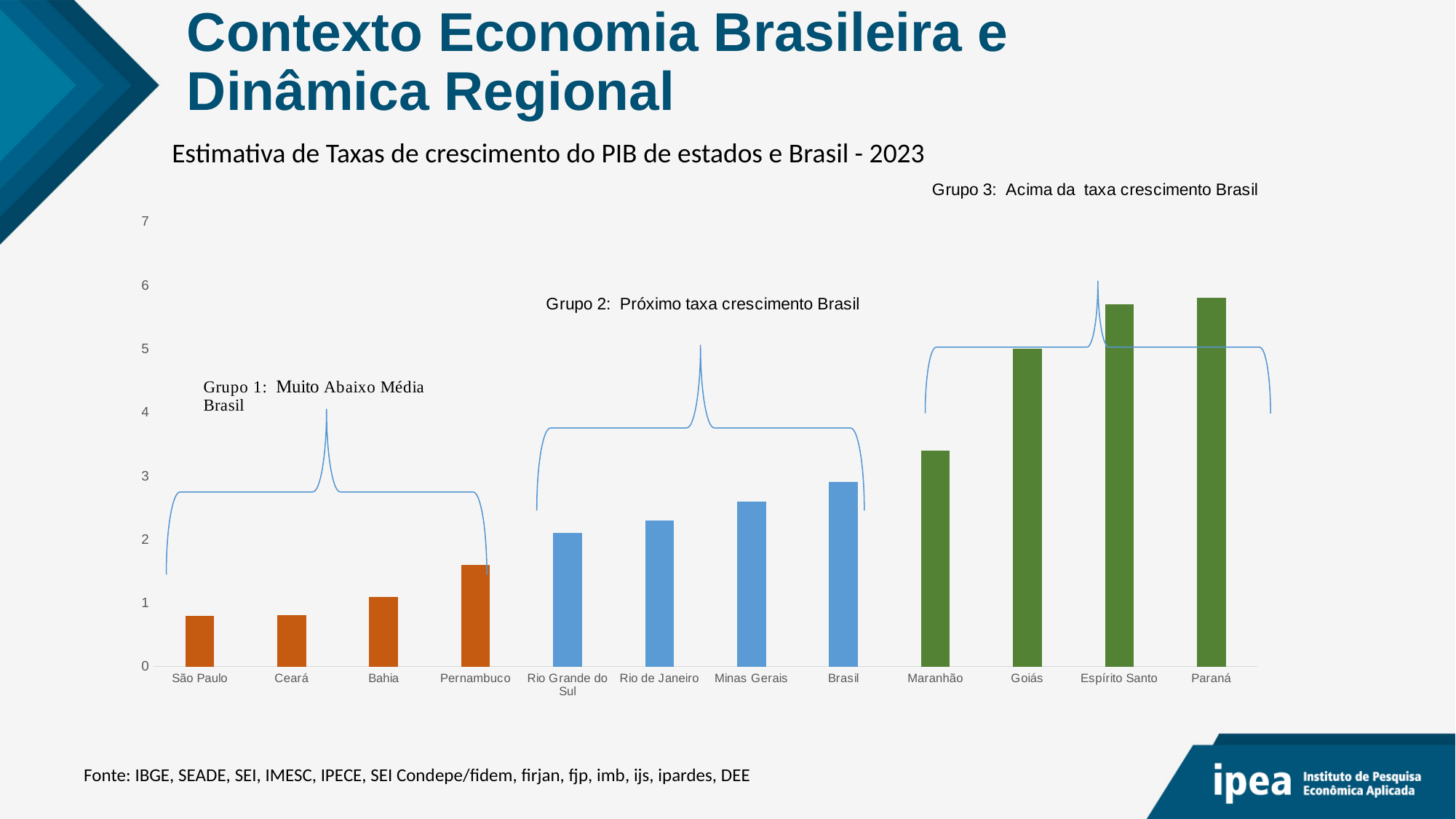
Which has the larger value, Brasil or Maranhão? Maranhão Is the value for Espírito Santo greater or less than 5? greater Is the value for Pernambuco greater or less than 2? less Is the value for Goiás greater or less than 4? greater What kind of chart is shown on the slide? bar chart Do the bar values rise or fall from left to right along the x axis? rise How many states/categories are plotted on the chart? 12 Which has the larger value, Bahia or Minas Gerais? Minas Gerais What is the title of the chart? Estimativa de Taxas de crescimento do PIB de estados e Brasil - 2023